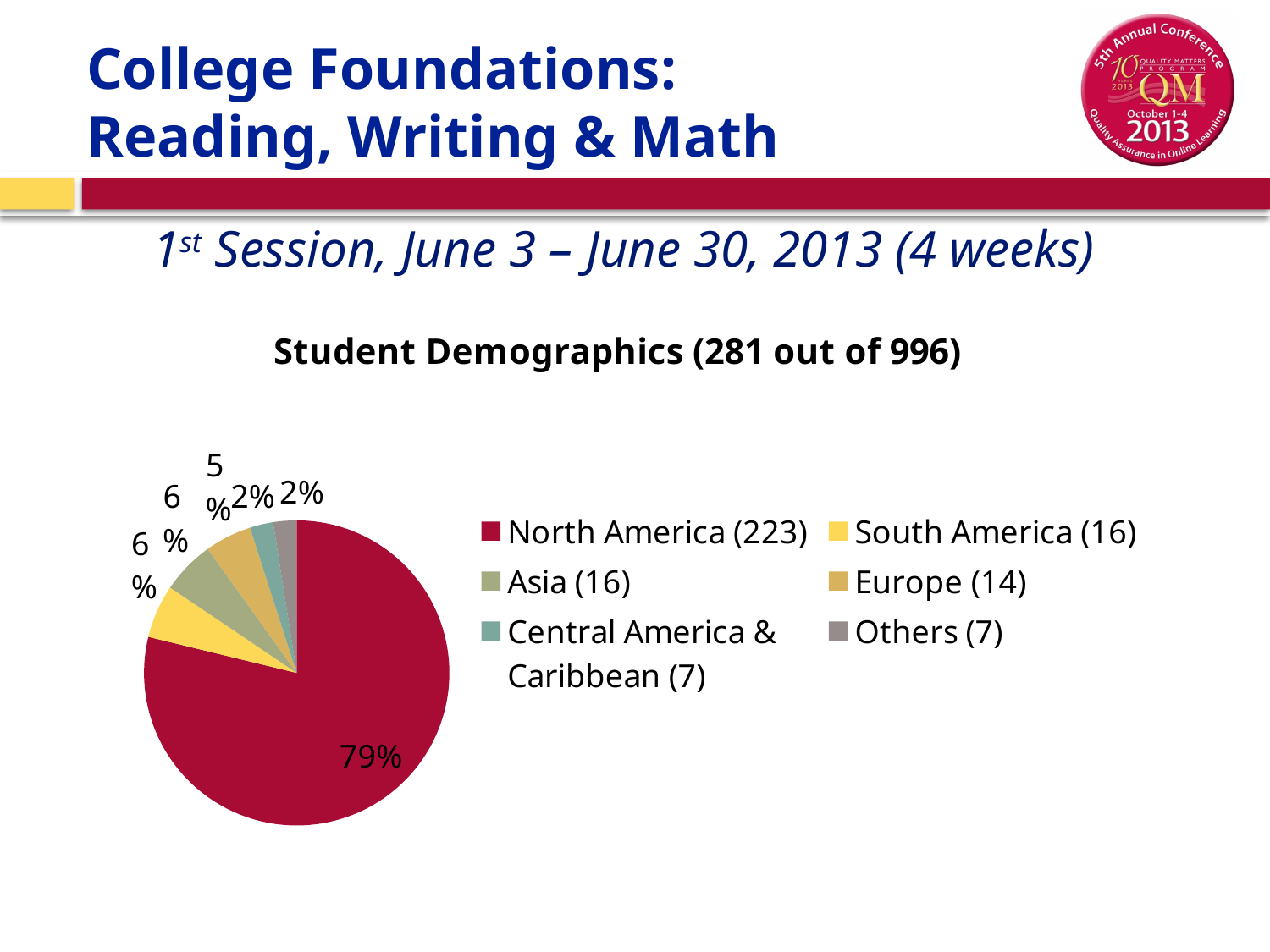
How many students are in the Europe category according to the legend? 14 What is the title of the chart? Student Demographics (281 out of 996) Which is larger, the number of students from North America or from South America? North America What kind of chart is shown on the slide? pie chart What is the difference between the number of students from North America and from South America? 207 What colour is the North America slice in the pie chart? dark red Which category has the largest slice of the pie? North America How many slices does the pie chart have? 6 How many students are in the North America category according to the legend? 223 How many students are in the Asia category according to the legend? 16 How many categories does the legend of the pie chart list? 6 What share of the pie does North America account for? 79%